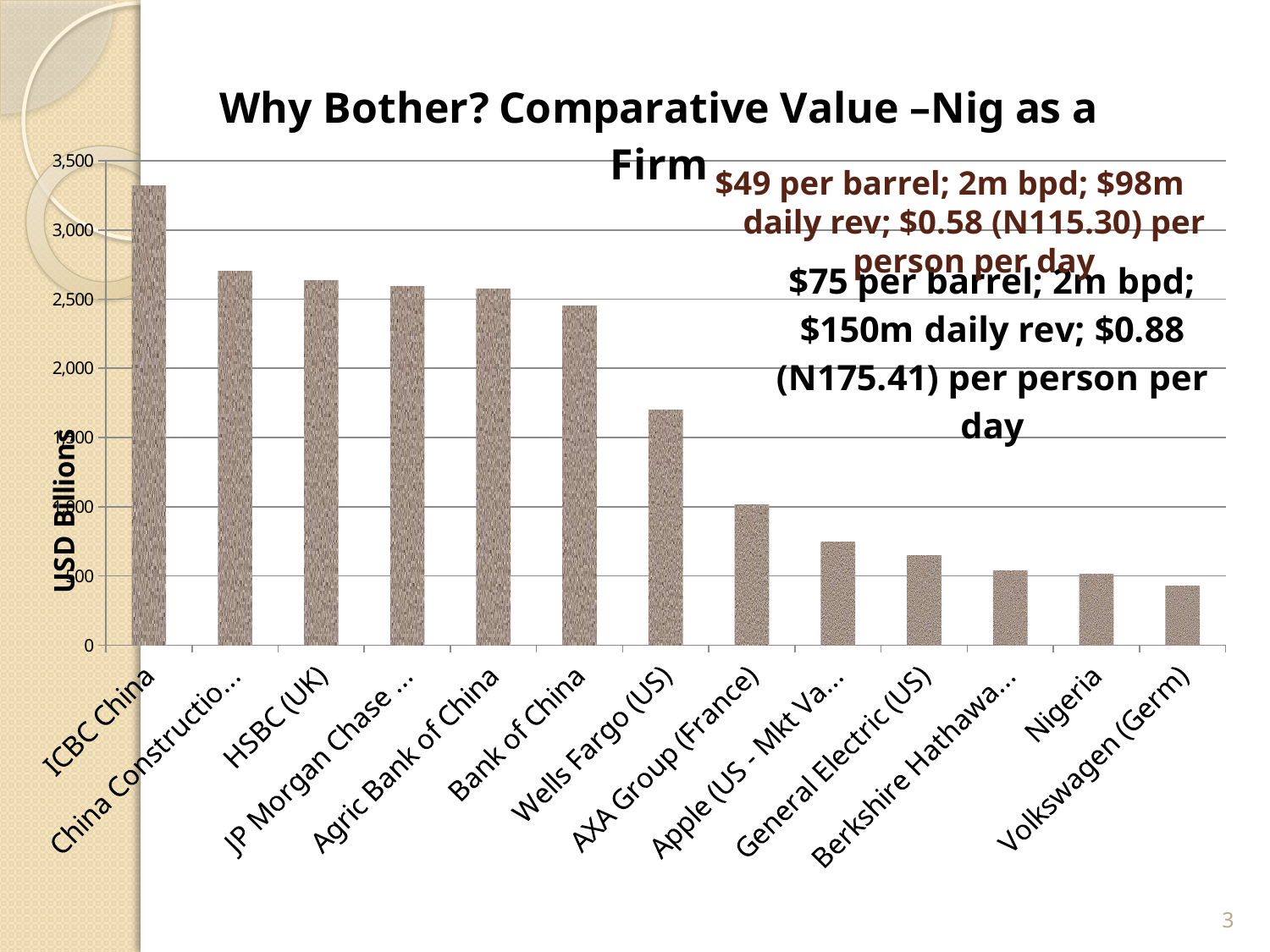
Is the value for General Electric (US) greater or less than 500? greater What kind of chart is shown on the slide? bar chart Is the value for Wells Fargo (US) greater or less than 2,000? less How many categories are plotted on the x axis? 13 Which is larger, the value for Wells Fargo (US) or the value for AXA Group (France)? Wells Fargo (US) Which category has the highest bar? ICBC China Is the value for ICBC China greater or less than 3,000? greater What is the label on the vertical axis? USD Billions Do the bar values rise or fall moving from left to right along the x axis? fall Which category has the lowest bar? Volkswagen (Germ)